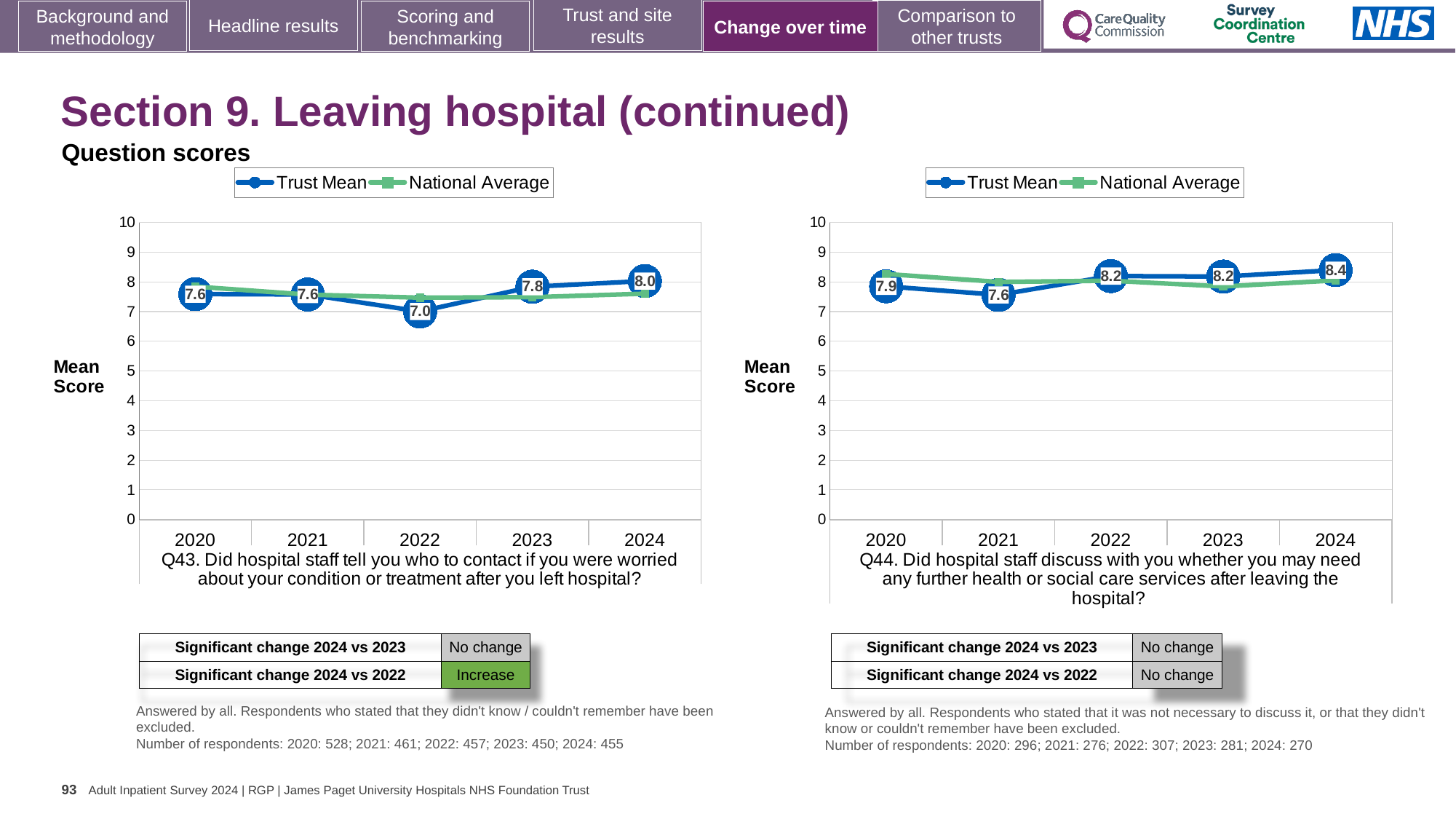
On the Q44 chart (right), what is the Trust Mean score for 2024? 8.4 On the Q44 chart (right), which year has the lowest Trust Mean score? 2021 On the Q44 chart (right), how many years are plotted on the x axis? 5 On the Q43 chart (left), what is the Trust Mean score for 2024? 8.0 On the Q43 chart (left), which year has the highest Trust Mean score? 2024 On the Q44 chart (right), what is the Trust Mean score for 2020? 7.9 On the Q43 chart (left), what is the difference between the Trust Mean scores for 2024 and 2022? 1.0 On the Q44 chart (right), is the Trust Mean score for 2021 greater or less than the Trust Mean score for 2022? less What kind of chart is the Q44 chart (right)? Line chart On the Q43 chart (left), which year has the lowest Trust Mean score? 2022 How many series does the legend of the Q43 chart (left) list? 2 On the Q43 chart (left), what is the Trust Mean score for 2022? 7.0